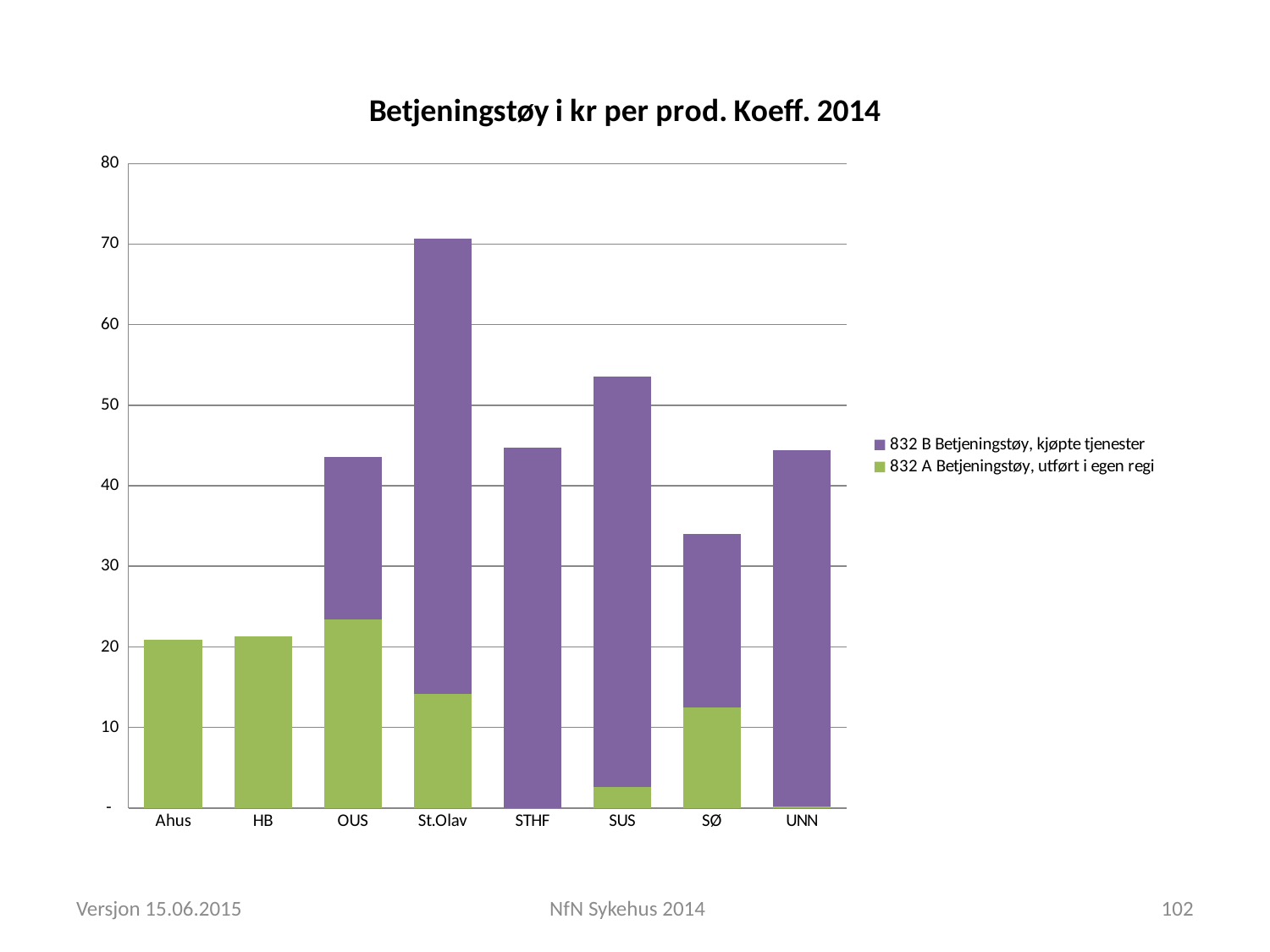
Which hospital has the highest total bar? St.Olav Which has the larger total bar, OUS or SØ? OUS Which has the larger total bar, SUS or STHF? SUS How many hospitals (categories) are shown on the x axis? 8 Is the total bar for St.Olav greater or less than 60? greater Is the total bar for SØ greater or less than 40? less Is the '832 A Betjeningstøy, utført i egen regi' value for St.Olav greater or less than 20? less Which hospital has the largest value for '832 B Betjeningstøy, kjøpte tjenester'? St.Olav What is the title of the chart? Betjeningstøy i kr per prod. Koeff. 2014 What kind of chart is shown on the slide? Stacked bar chart How many series does the legend list? 2